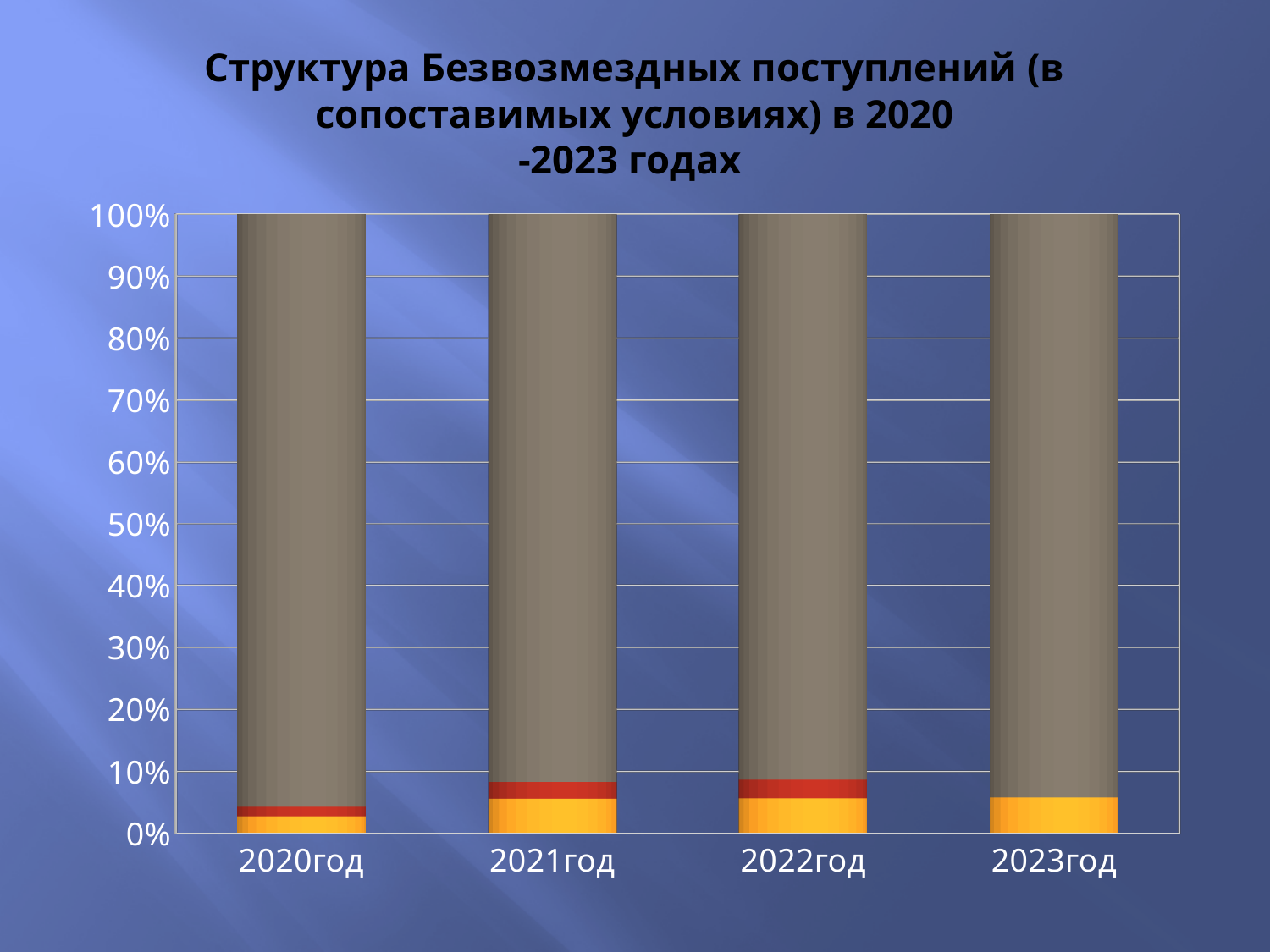
Which year's bar has no red segment? 2023год Is the yellow segment for 2022год greater or less than 20%? less Is the yellow segment for 2020год greater or less than 10%? less Is the yellow segment for 2021год greater or less than 10%? less Is the red segment larger for 2020год or for 2022год? 2022год How many years (categories) are shown on the x axis of the chart? 4 What kind of chart is shown on the slide? bar chart Which year has the smallest yellow segment? 2020год What is the title of the chart? Структура Безвозмездных поступлений (в сопоставимых условиях) в 2020-2023 годах Is the yellow segment larger for 2020год or for 2023год? 2023год